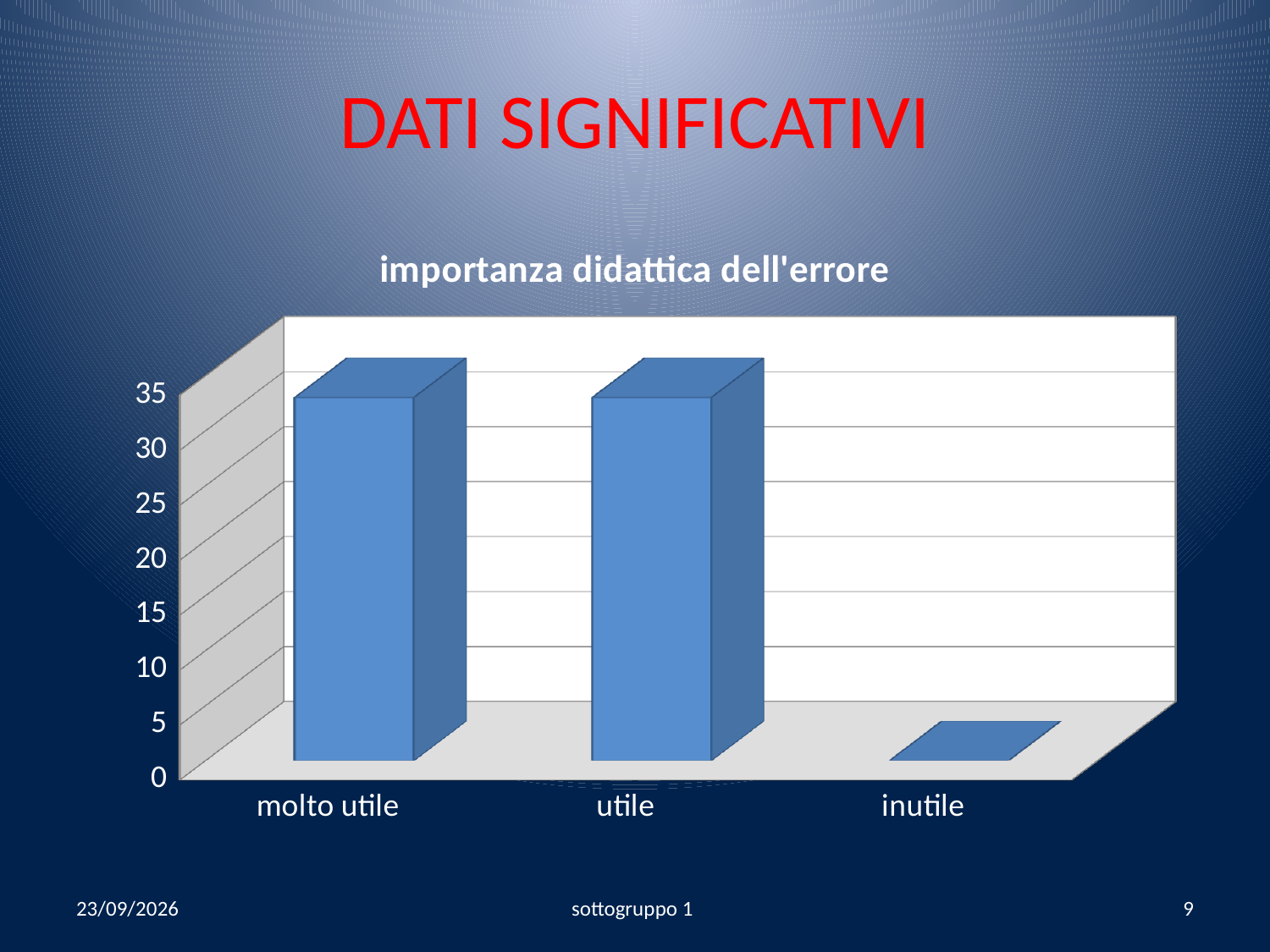
Is the value for utile greater or less than 30? greater Is the value for inutile greater or less than 5? less How many categories are shown on the x axis of the chart? 3 Which category has the lowest value in the chart? inutile Which is larger, the value for molto utile or the value for inutile? molto utile What is the title of the chart? importanza didattica dell'errore Do the values rise or fall from utile to inutile along the x axis? fall Is the value for molto utile greater or less than 30? greater What kind of chart is shown on the slide? bar chart Which is larger, the value for utile or the value for inutile? utile What is the highest tick value shown on the vertical axis of the chart? 35